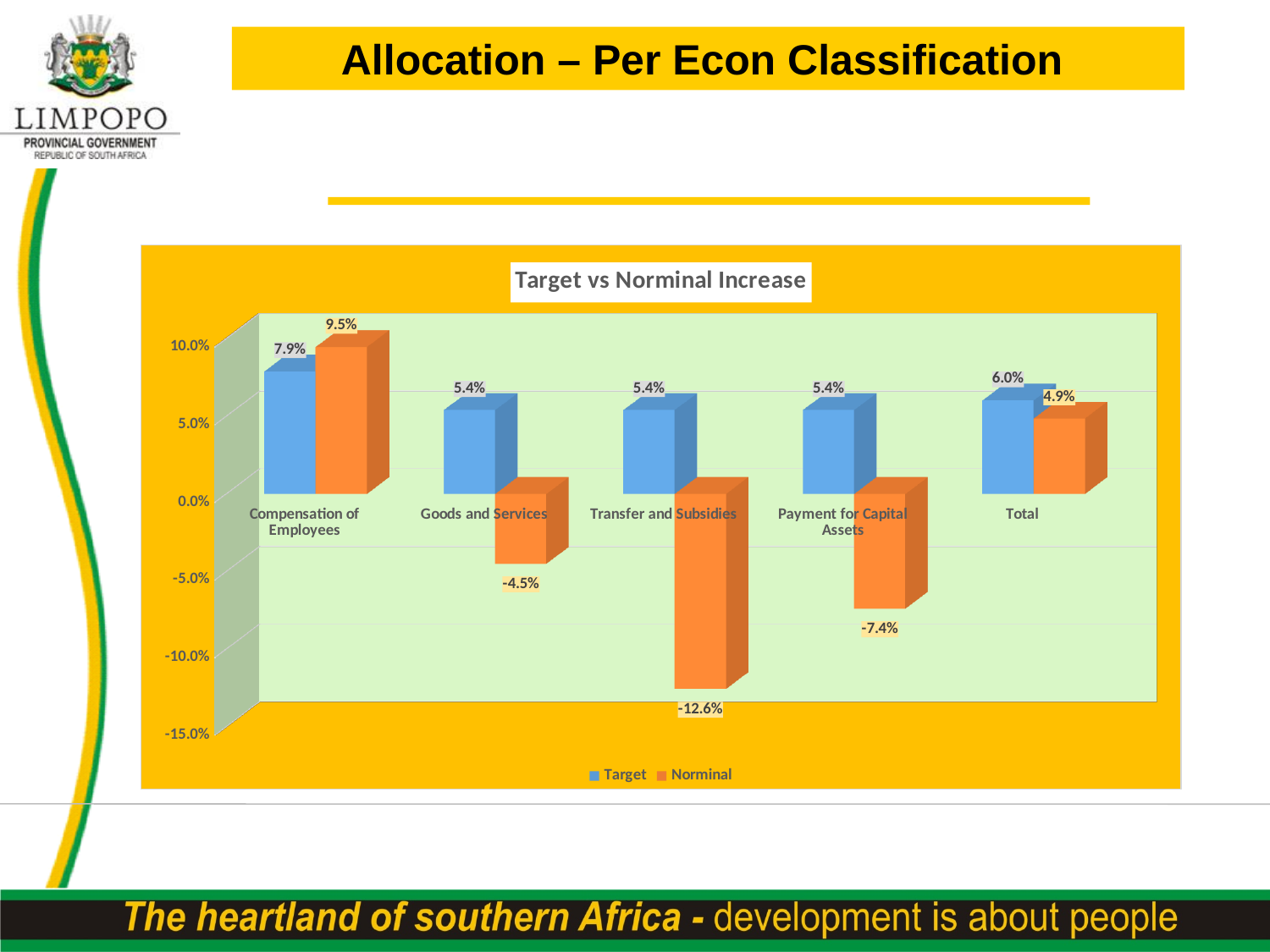
What is the Target value for Total? 6.0% What is the Norminal value for Transfer and Subsidies? -12.6% What is the Norminal value for Goods and Services? -4.5% What is the difference between the Norminal and Target values for Compensation of Employees? 1.6% Is the Norminal value for Payment for Capital Assets greater or less than -5.0%? less What type of chart is shown on the slide? Bar chart How many categories are shown on the x axis? 5 Which category has the lowest Norminal value? Transfer and Subsidies What is the Target value for Compensation of Employees? 7.9% For Total, which is larger: the Target value or the Norminal value? Target How many series does the legend list? 2 Which category has the highest Norminal value? Compensation of Employees